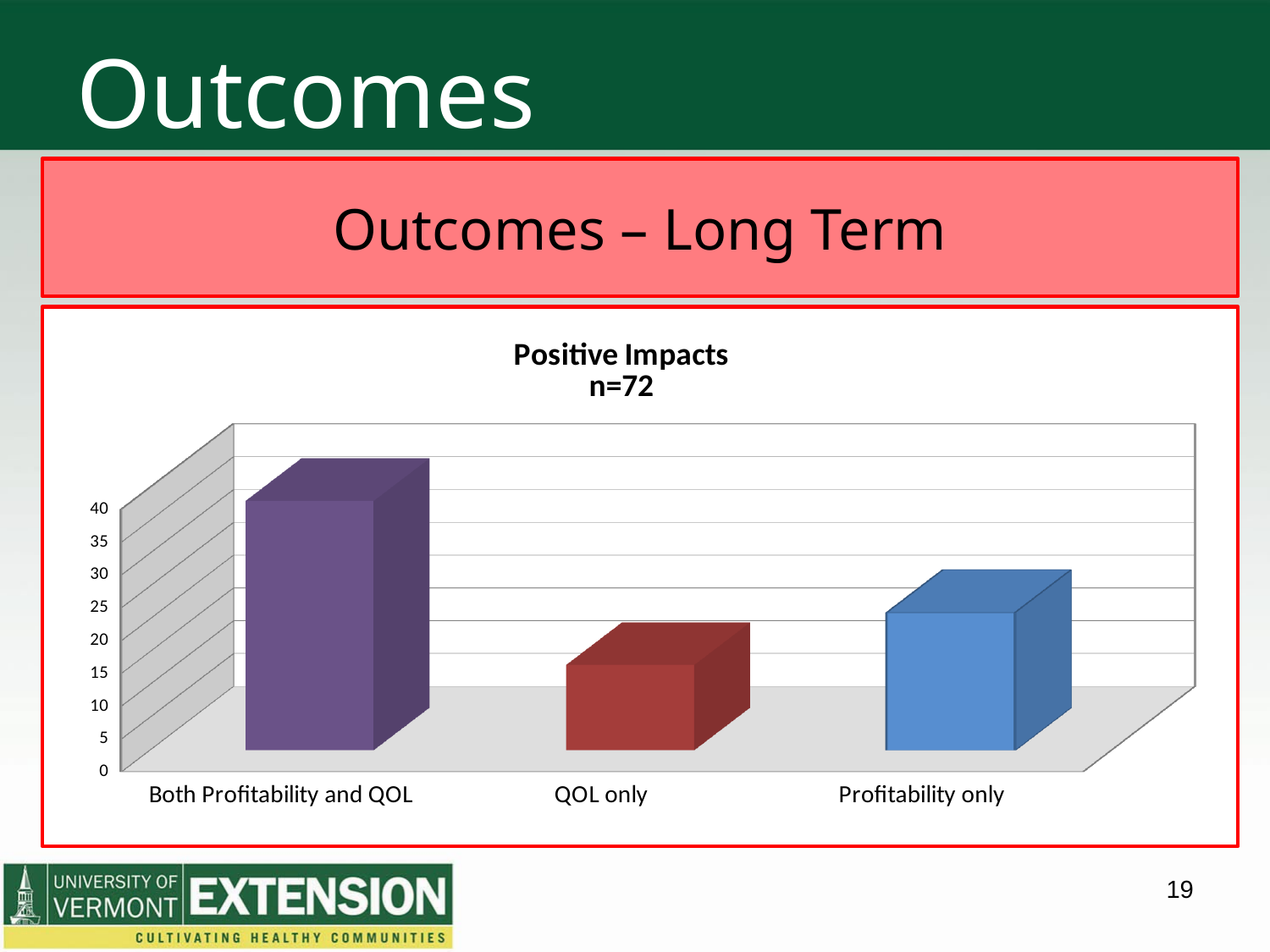
Which category has the highest bar in the chart? Both Profitability and QOL Is the value for Profitability only greater or less than 30? less What is the title of the chart? Positive Impacts n=72 Which category has the lowest bar in the chart? QOL only Which is larger, the value for Both Profitability and QOL or the value for Profitability only? Both Profitability and QOL Is the value for Both Profitability and QOL greater or less than 30? greater What kind of chart is shown on the slide? bar chart What sample size (n) is stated in the chart title? 72 Which is larger, the value for Profitability only or the value for QOL only? Profitability only How many categories are shown on the x axis of the chart? 3 Is the value for QOL only greater or less than 20? less